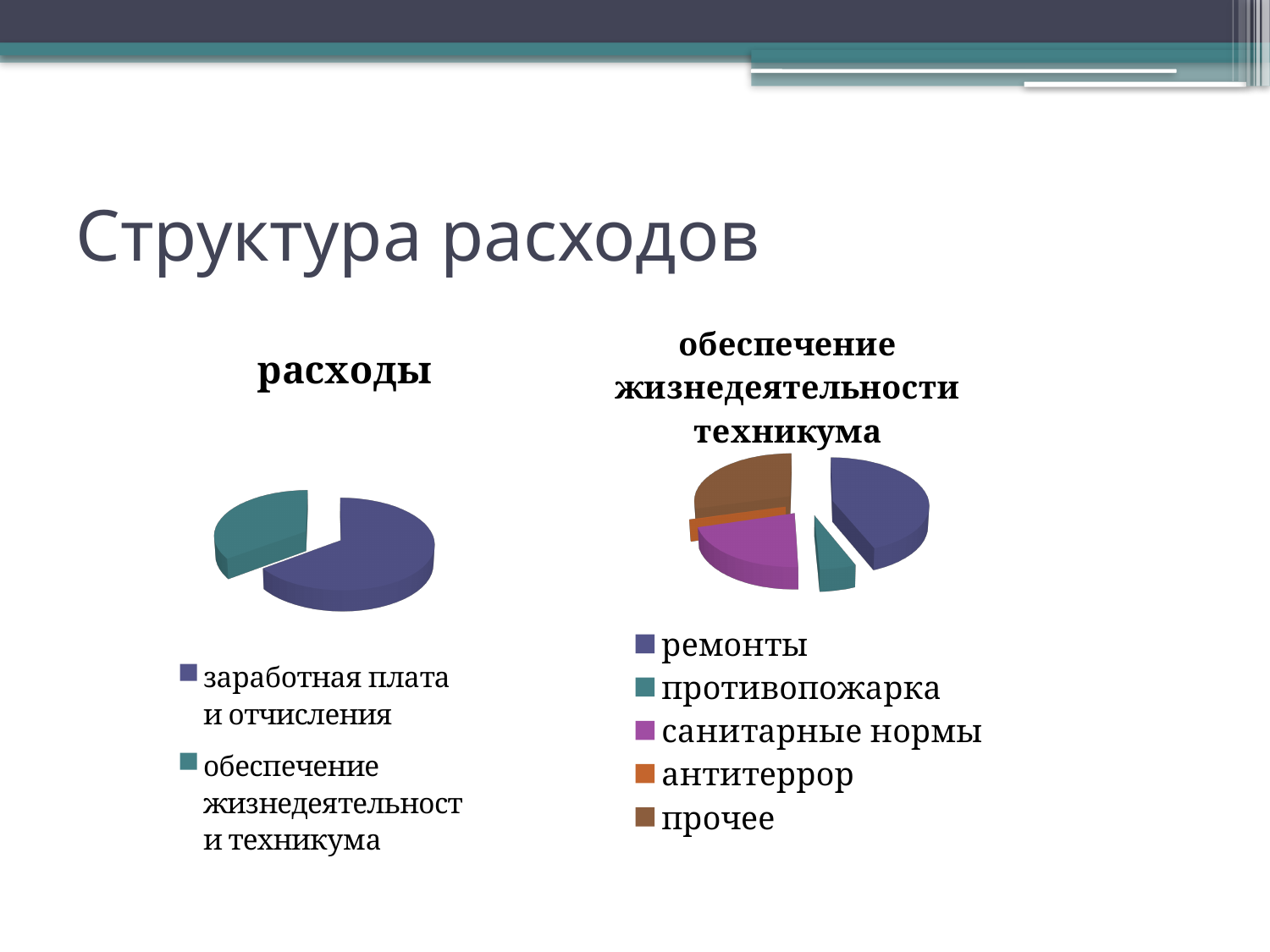
In the chart titled "обеспечение жизнедеятельности техникума", how many categories does the legend list? 5 In the chart titled "обеспечение жизнедеятельности техникума", what colour is the slice for санитарные нормы? magenta (purple-pink) In the chart titled "расходы", which category has the largest slice? заработная плата и отчисления In the chart titled "обеспечение жизнедеятельности техникума", which slice is larger: противопожарка or антитеррор? противопожарка How many pie charts are shown on the slide? 2 In the chart titled "расходы", how many categories does the legend list? 2 In the chart titled "расходы", which category has the smallest slice? обеспечение жизнедеятельности техникума In the chart titled "обеспечение жизнедеятельности техникума", which slice is larger: прочее or противопожарка? прочее In the chart titled "обеспечение жизнедеятельности техникума", which category has the smallest slice? антитеррор In the chart titled "обеспечение жизнедеятельности техникума", which category has the largest slice? ремонты What kind of chart is the chart titled "обеспечение жизнедеятельности техникума"? pie chart What kind of chart is the chart titled "расходы"? pie chart